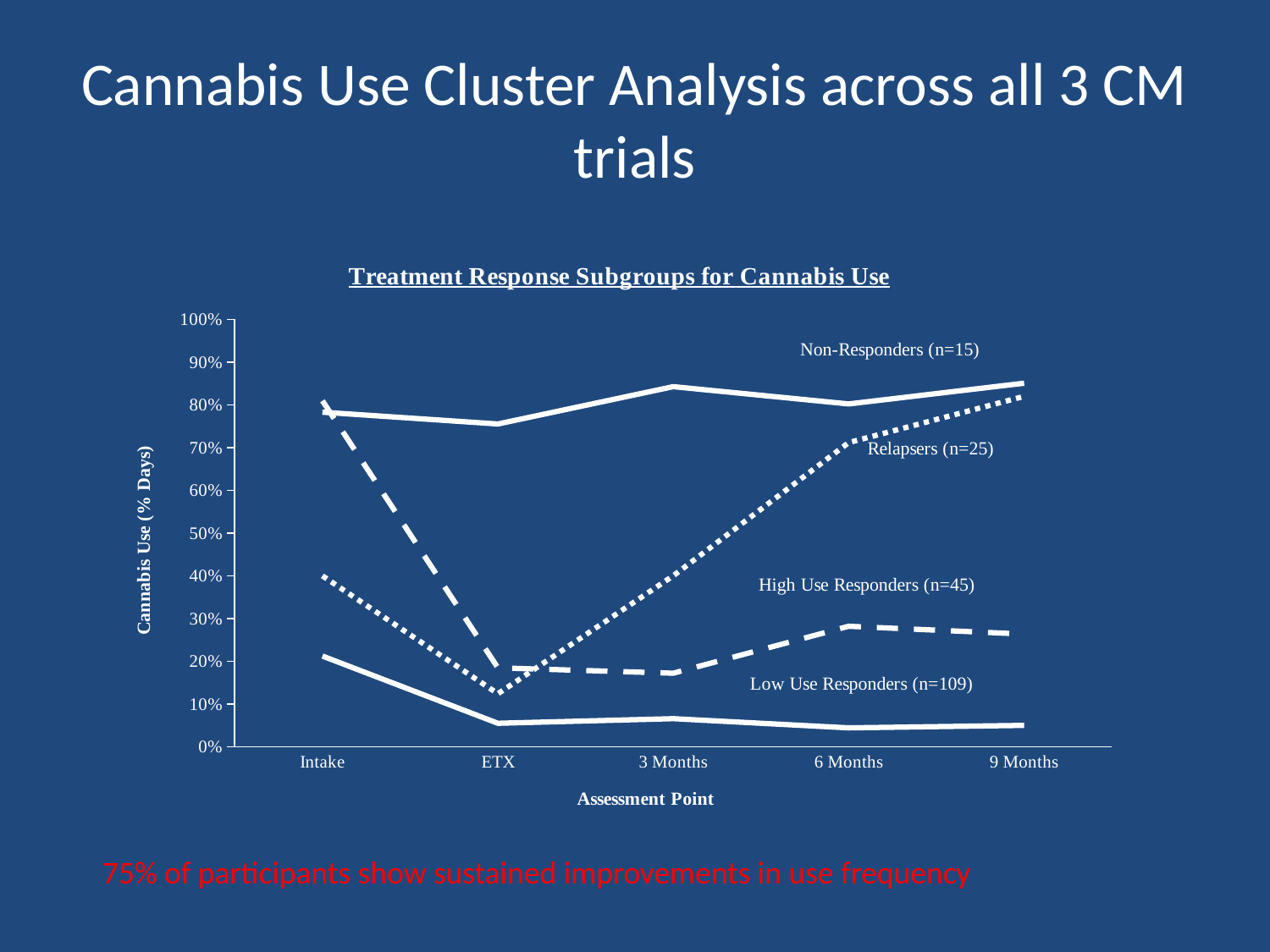
How many treatment response subgroups are plotted on the chart? 4 Which subgroup has the lowest cannabis use at 9 Months? Low Use Responders (n=109) How many assessment points are shown on the x axis? 5 Is the value for High Use Responders (n=45) at 6 Months greater or less than 40%? less Is the value for Non-Responders (n=15) at Intake greater or less than 70%? greater What is the title of the chart? Treatment Response Subgroups for Cannabis Use Is the value for Low Use Responders (n=109) at ETX greater or less than 10%? less Which subgroup has the highest cannabis use at Intake? High Use Responders (n=45) Does the Relapsers (n=25) line rise or fall from ETX to 9 Months? rise At 3 Months, which is larger: the value for Relapsers (n=25) or for High Use Responders (n=45)? Relapsers (n=25) What type of chart is shown on the slide? line chart